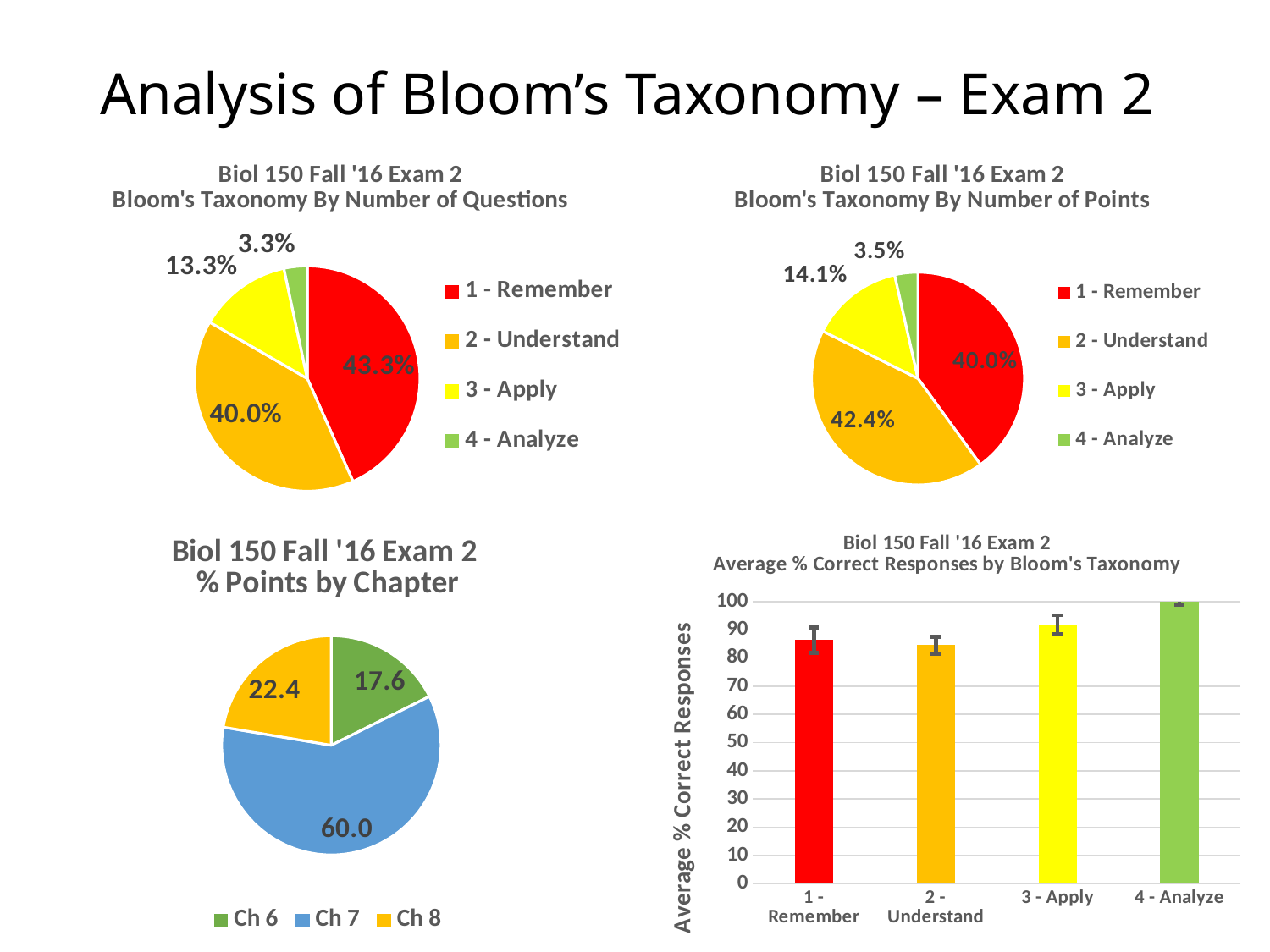
In the 'Average % Correct Responses by Bloom's Taxonomy' chart, how many categories are shown on the x axis? 4 What kind of chart is 'Average % Correct Responses by Bloom's Taxonomy'? bar chart In the 'Bloom's Taxonomy By Number of Points' pie chart, what percentage is labelled for 2 - Understand? 42.4% In the 'Bloom's Taxonomy By Number of Questions' pie chart, what percentage is labelled for 1 - Remember? 43.3% In the 'Bloom's Taxonomy By Number of Points' pie chart, what is the difference between the 3 - Apply and 4 - Analyze percentages? 10.6% In the 'Average % Correct Responses by Bloom's Taxonomy' chart, is the value for 2 - Understand greater or less than 80? greater In the '% Points by Chapter' pie chart, which chapter has the smallest share? Ch 6 In the 'Average % Correct Responses by Bloom's Taxonomy' chart, which category has the highest average % correct? 4 - Analyze In the 'Bloom's Taxonomy By Number of Points' pie chart, which category has the largest share? 2 - Understand How many categories does the legend of the '% Points by Chapter' pie chart list? 3 In the '% Points by Chapter' pie chart, what value is labelled for Ch 7? 60.0 In the 'Bloom's Taxonomy By Number of Questions' pie chart, which category has the smallest share? 4 - Analyze